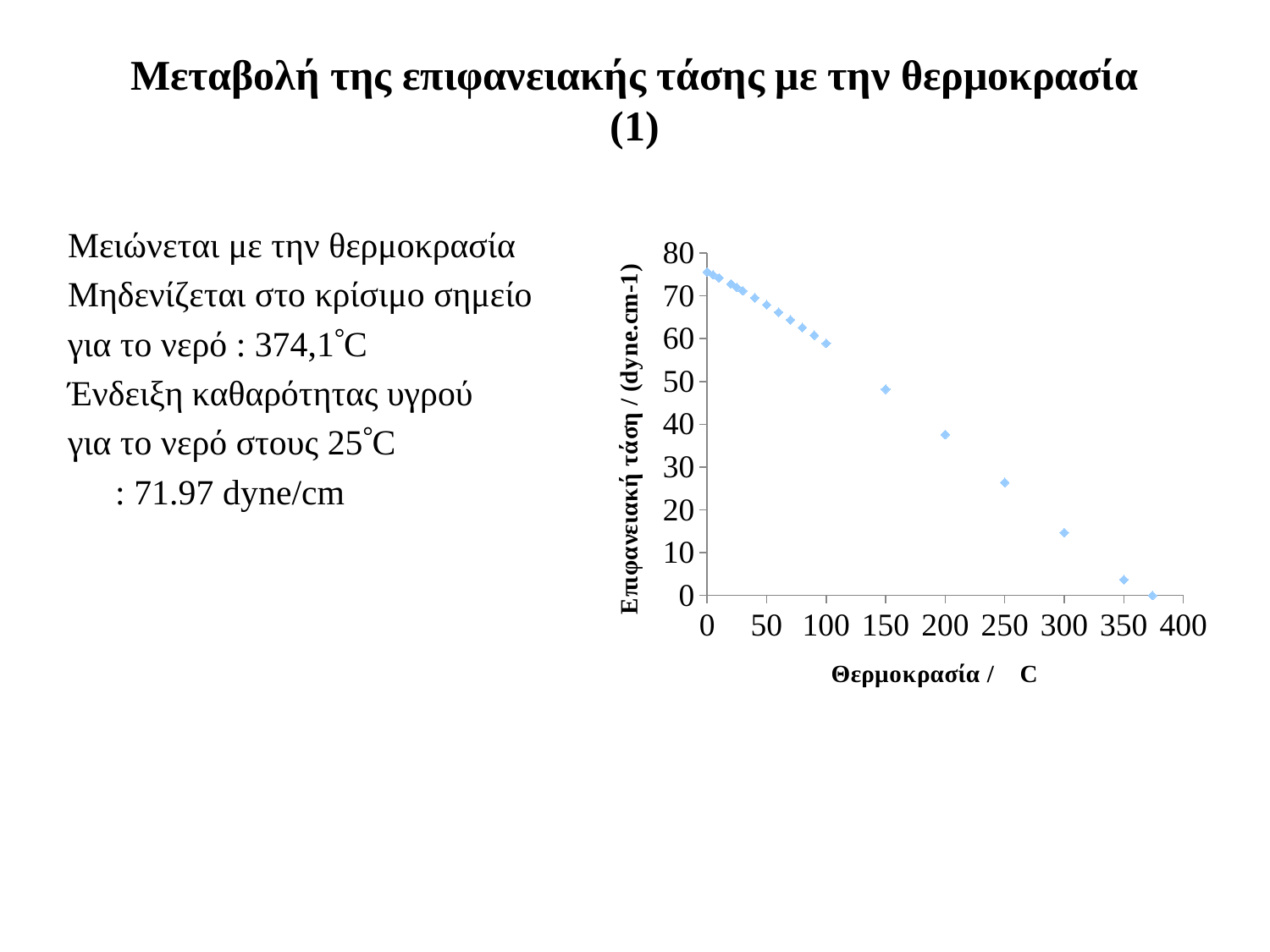
What kind of chart is shown on the slide? scatter chart Is the surface tension value at 300 °C greater or less than 20? less Is the surface tension value at 250 °C greater or less than 20? greater Is the surface tension value at 200 °C greater or less than 30? greater Which has the larger surface tension value, the point at 150 °C or the point at 300 °C? 150 °C What is the title of the y axis of the chart? Επιφανειακή τάση / (dyne.cm-1) Do the plotted values rise or fall as temperature increases along the x axis? fall What is the maximum value shown on the y axis of the chart? 80 At which temperature on the x axis is the plotted surface tension highest? 0